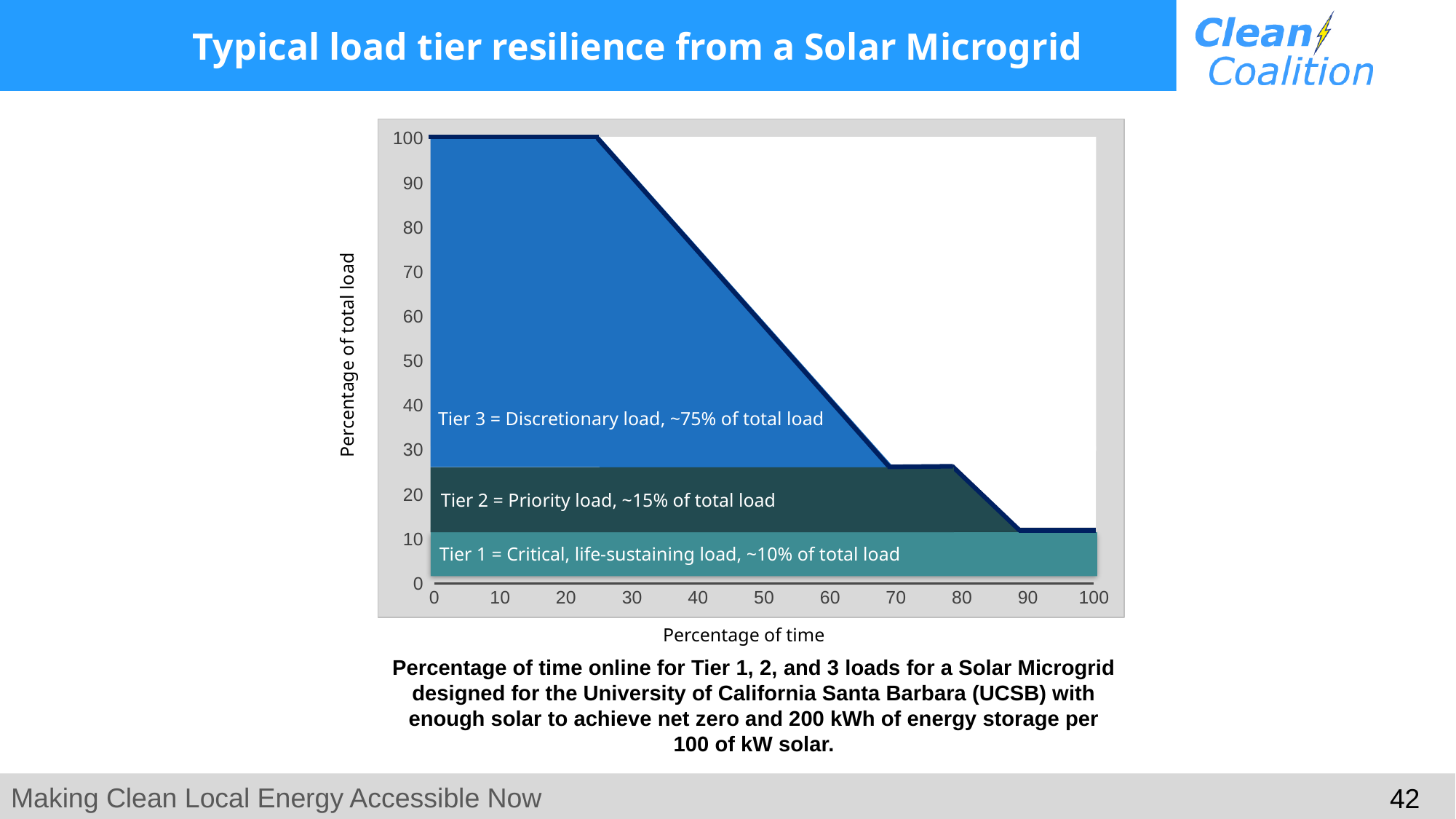
What kind of chart is shown on the slide? Area chart What is the title of the chart on the slide? Typical load tier resilience from a Solar Microgrid Is the percentage of total load at 60 percent of time greater or less than 30? greater What is the percentage of total load at 0 percent of time? 100 Which is larger, the percentage of total load at 10 percent of time or at 100 percent of time? 10 percent of time How many load tiers are labelled on the chart? 3 What is the percentage of total load at 20 percent of time? 100 Is the percentage of total load at 50 percent of time greater or less than 50? greater Is the percentage of total load at 90 percent of time greater or less than 20? less Does the percentage of total load rise or fall as the percentage of time increases? fall What is the label of the vertical axis? Percentage of total load